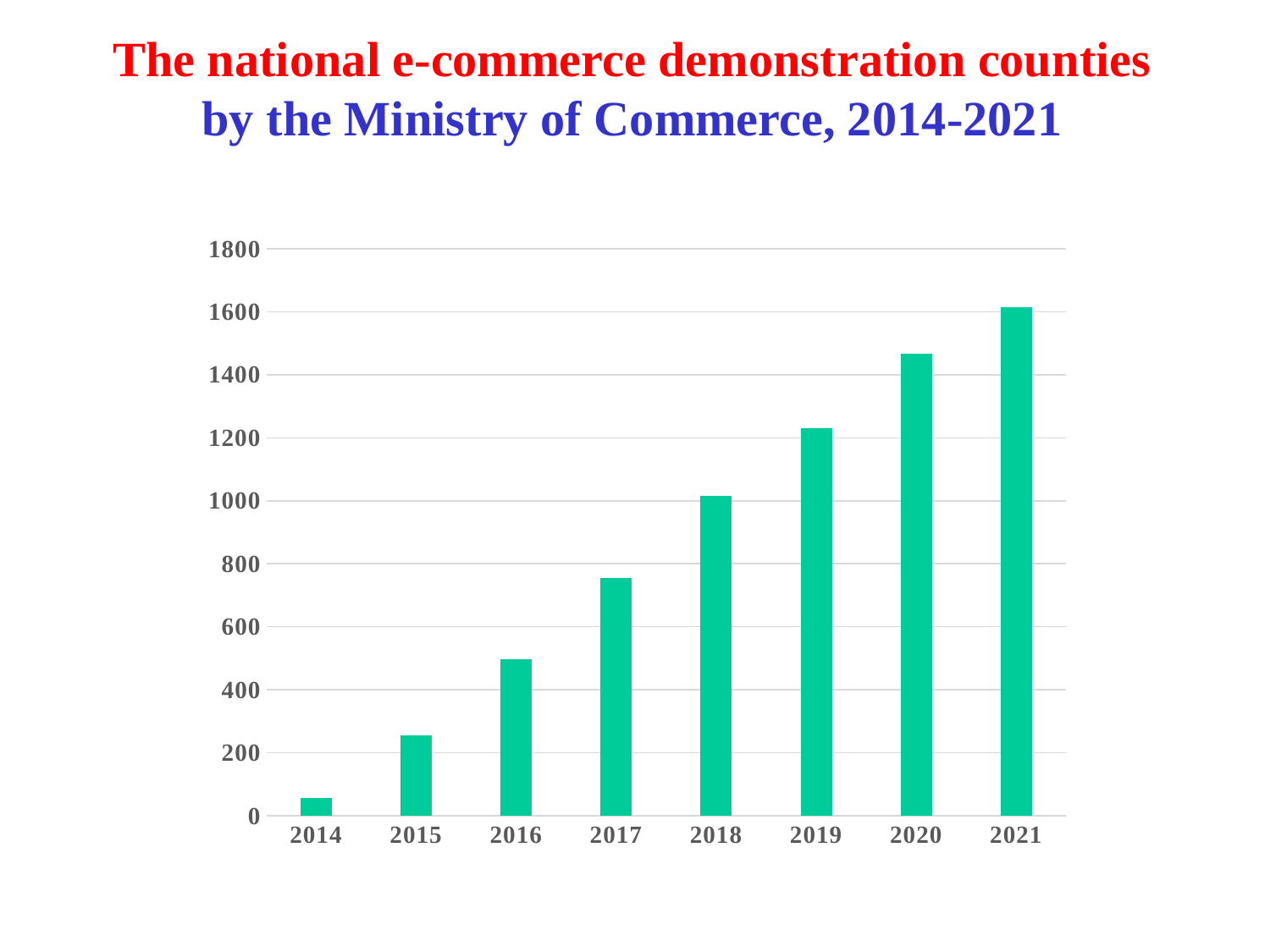
Is the value for 2021 greater or less than 1800? less Which year has the lowest number of national e-commerce demonstration counties? 2014 Is the value for 2017 greater or less than 800? less Which year has the highest number of national e-commerce demonstration counties? 2021 Is the value for 2020 greater or less than 1400? greater What is the title of the chart on the slide? The national e-commerce demonstration counties by the Ministry of Commerce, 2014-2021 Which year has a larger value, 2018 or 2017? 2018 How many years are shown on the x axis of the chart? 8 Do the values rise or fall from 2014 to 2021? rise What kind of chart is shown on the slide? bar chart